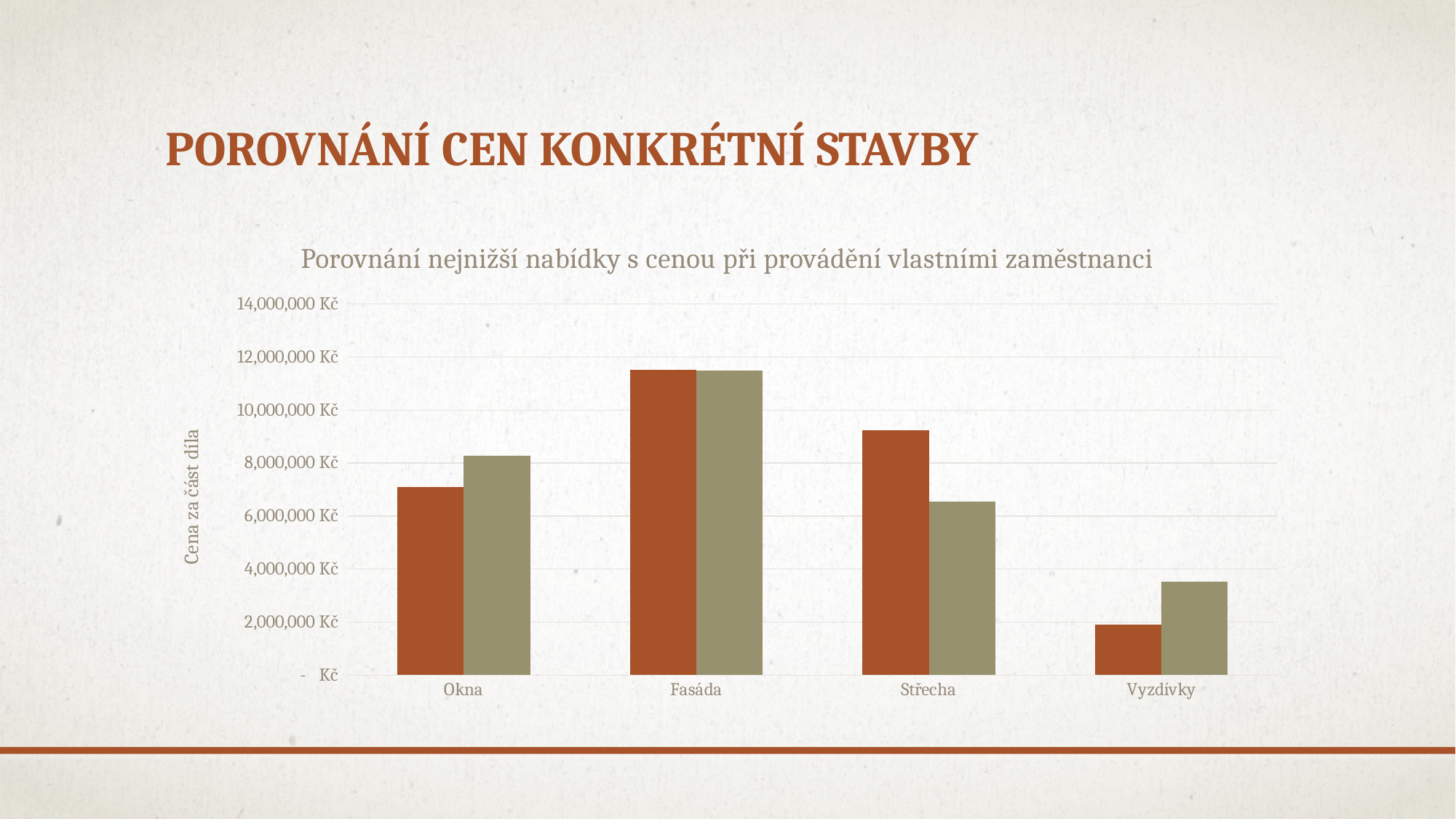
For Okna, which bar is taller, the orange (left) bar or the grey (right) bar? the grey (right) bar Is the value of the orange (left) bar for Okna greater or less than 6,000,000 Kč? greater What is the title of the chart? Porovnání nejnižší nabídky s cenou při provádění vlastními zaměstnanci Is the value of the orange (left) bar for Fasáda greater or less than 10,000,000 Kč? greater Which category has the tallest bars in the chart? Fasáda How many categories are shown on the x axis of the chart? 4 What kind of chart is shown on the slide? bar chart Which category has the shortest bars in the chart? Vyzdívky What is the label of the vertical axis of the chart? Cena za část díla Is the value of the grey (right) bar for Vyzdívky greater or less than 4,000,000 Kč? less For Střecha, which bar is taller, the orange (left) bar or the grey (right) bar? the orange (left) bar